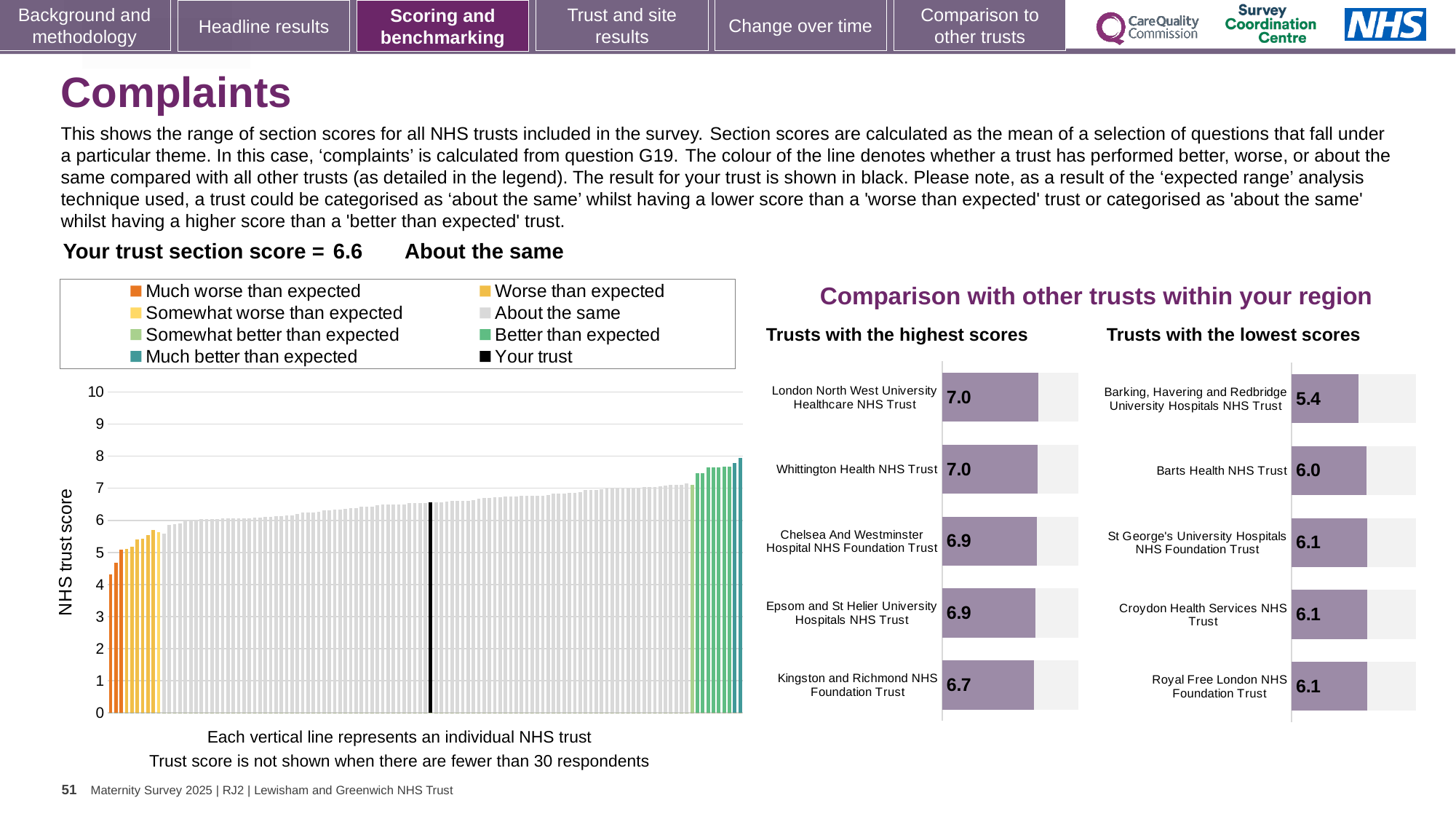
In the 'Trusts with the lowest scores' chart, what is the score for Barking, Havering and Redbridge University Hospitals NHS Trust? 5.4 In the main 'NHS trust score' chart on the left, do the trust scores rise or fall from left to right? rise In the 'Trusts with the highest scores' chart, what is the score for Kingston and Richmond NHS Foundation Trust? 6.7 How many trusts are listed in the 'Trusts with the lowest scores' chart? 5 Which has the higher score: Kingston and Richmond NHS Foundation Trust in the highest-scores chart or Royal Free London NHS Foundation Trust in the lowest-scores chart? Kingston and Richmond NHS Foundation Trust In the 'Trusts with the highest scores' chart, what is the difference between the scores of London North West University Healthcare NHS Trust and Kingston and Richmond NHS Foundation Trust? 0.3 In the 'Trusts with the lowest scores' chart, what is the score for Barts Health NHS Trust? 6.0 In the 'Trusts with the lowest scores' chart, what is the difference between the scores of Barts Health NHS Trust and Barking, Havering and Redbridge University Hospitals NHS Trust? 0.6 In the 'Trusts with the lowest scores' chart, which trust has the lowest score? Barking, Havering and Redbridge University Hospitals NHS Trust In the main 'NHS trust score' chart on the left, how many entries does the legend list? 8 In the 'Trusts with the highest scores' chart, what is the score for London North West University Healthcare NHS Trust? 7.0 In the 'Trusts with the highest scores' chart, which trust has the lowest score shown? Kingston and Richmond NHS Foundation Trust